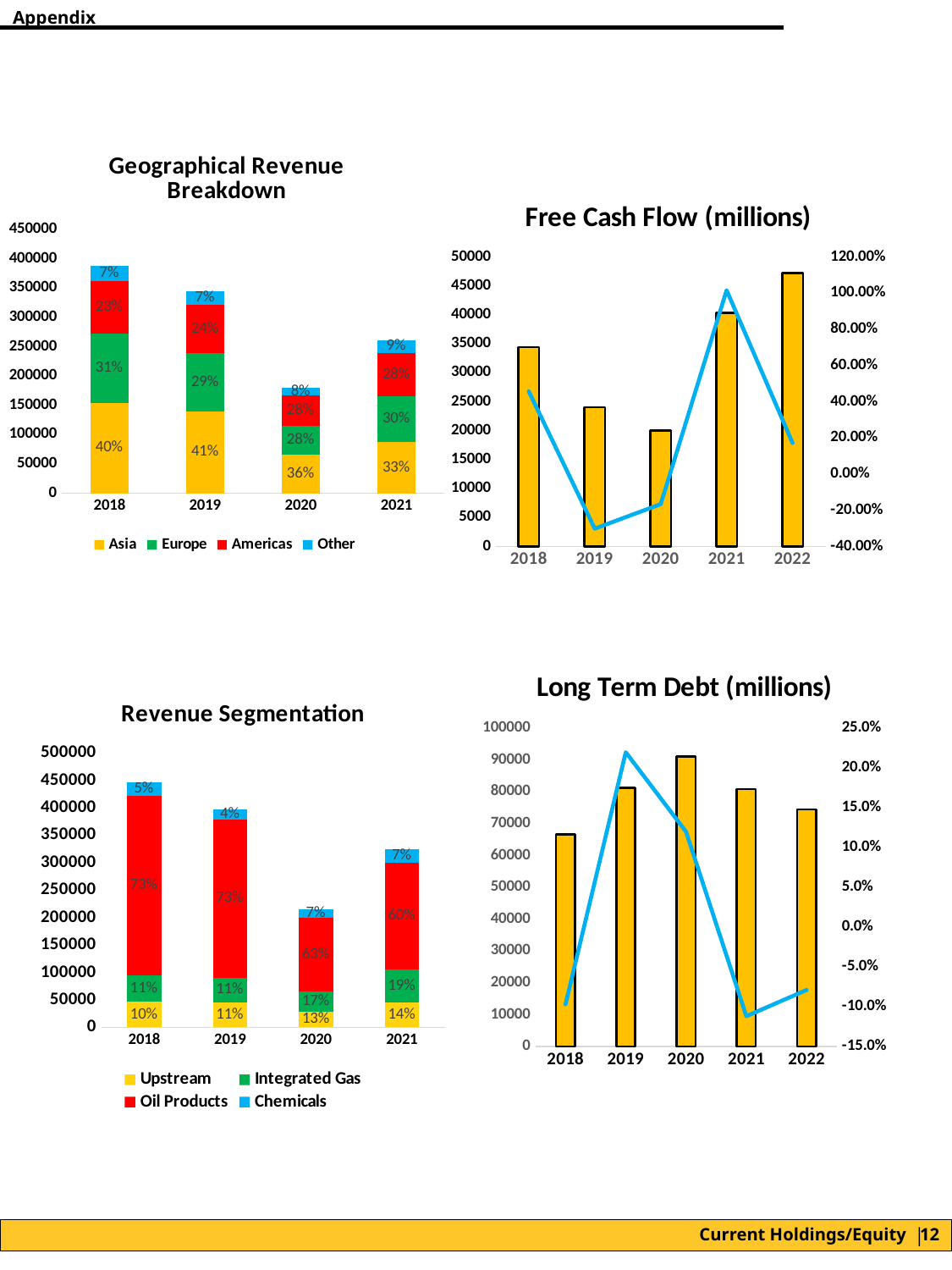
In the Geographical Revenue Breakdown chart, how many series does the legend list? 4 In the Long Term Debt (millions) chart, which year has the tallest bar? 2020 In the Free Cash Flow (millions) chart, which year has the shortest bar? 2020 In the Free Cash Flow (millions) chart, which year has the tallest bar? 2022 In the Free Cash Flow (millions) chart, is the bar value for 2022 greater or less than 45000? greater In the Revenue Segmentation chart, which is larger in 2021: the Integrated Gas share or the Upstream share? Integrated Gas In the Geographical Revenue Breakdown chart, what share of revenue did Americas account for in 2021? 28% In the Long Term Debt (millions) chart, is the bar value for 2018 greater or less than 70000? less In the Free Cash Flow (millions) chart, how many years are shown on the x axis? 5 In the Geographical Revenue Breakdown chart, what share of revenue did Asia account for in 2018? 40% In the Geographical Revenue Breakdown chart, what is the difference between the Asia share in 2019 and the Asia share in 2021? 8% In the Revenue Segmentation chart, what share did Oil Products account for in 2020? 63%